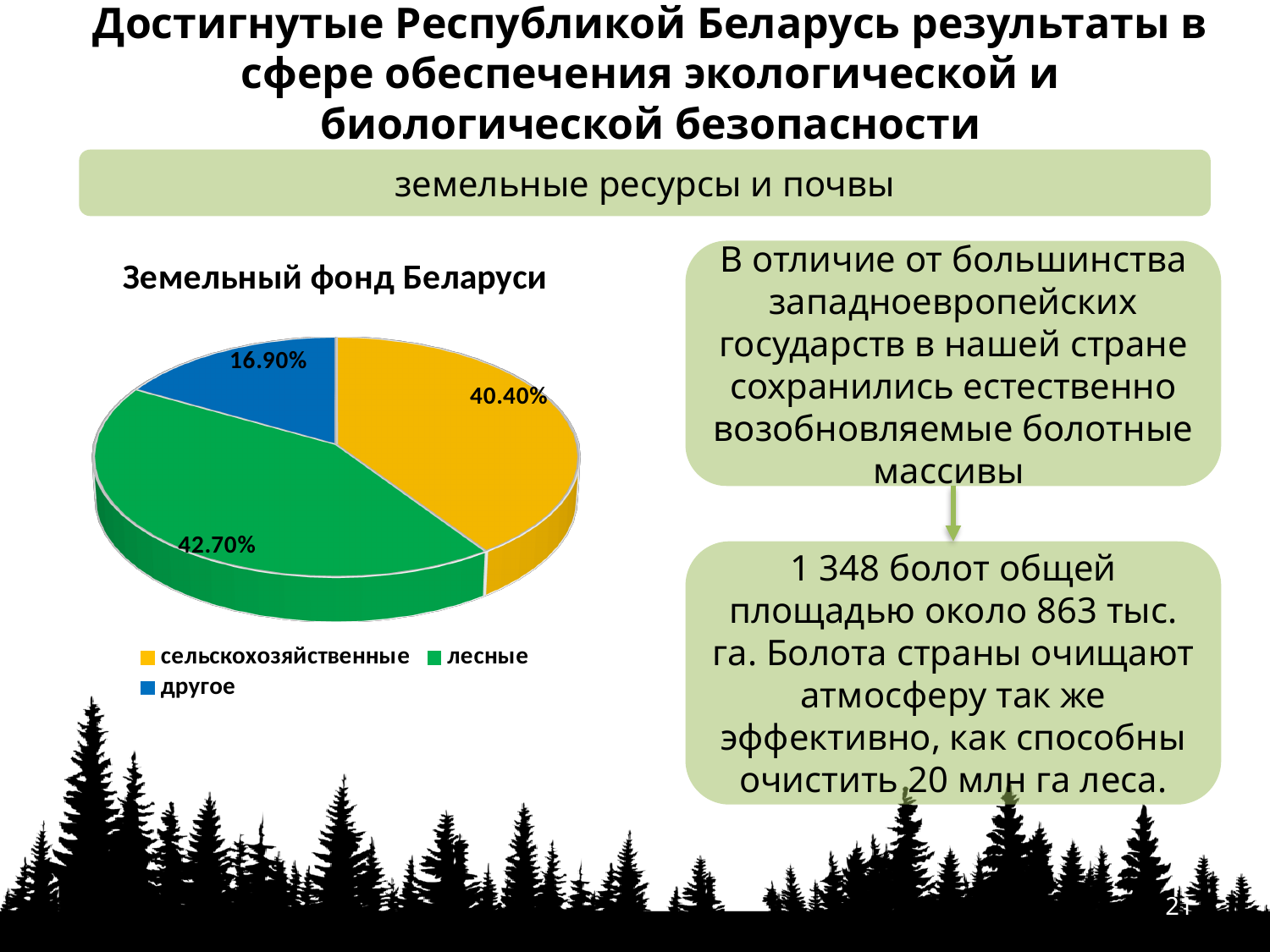
What is the value for "сельскохозяйственные" in the pie chart? 40.40% What is the difference between the shares of "лесные" and "сельскохозяйственные"? 2.30% Which colour represents "другое" in the pie chart? blue What type of chart is shown under the title "Земельный фонд Беларуси"? pie chart Which is larger in the pie chart: "сельскохозяйственные" or "другое"? сельскохозяйственные What is the title of the pie chart? Земельный фонд Беларуси Which category has the largest share in the pie chart? лесные What is the value for "лесные" in the pie chart? 42.70% Which category has the smallest share in the pie chart? другое What is the value for "другое" in the pie chart? 16.90% What is the difference between the shares of "сельскохозяйственные" and "другое"? 23.50% How many slices does the pie chart have? 3